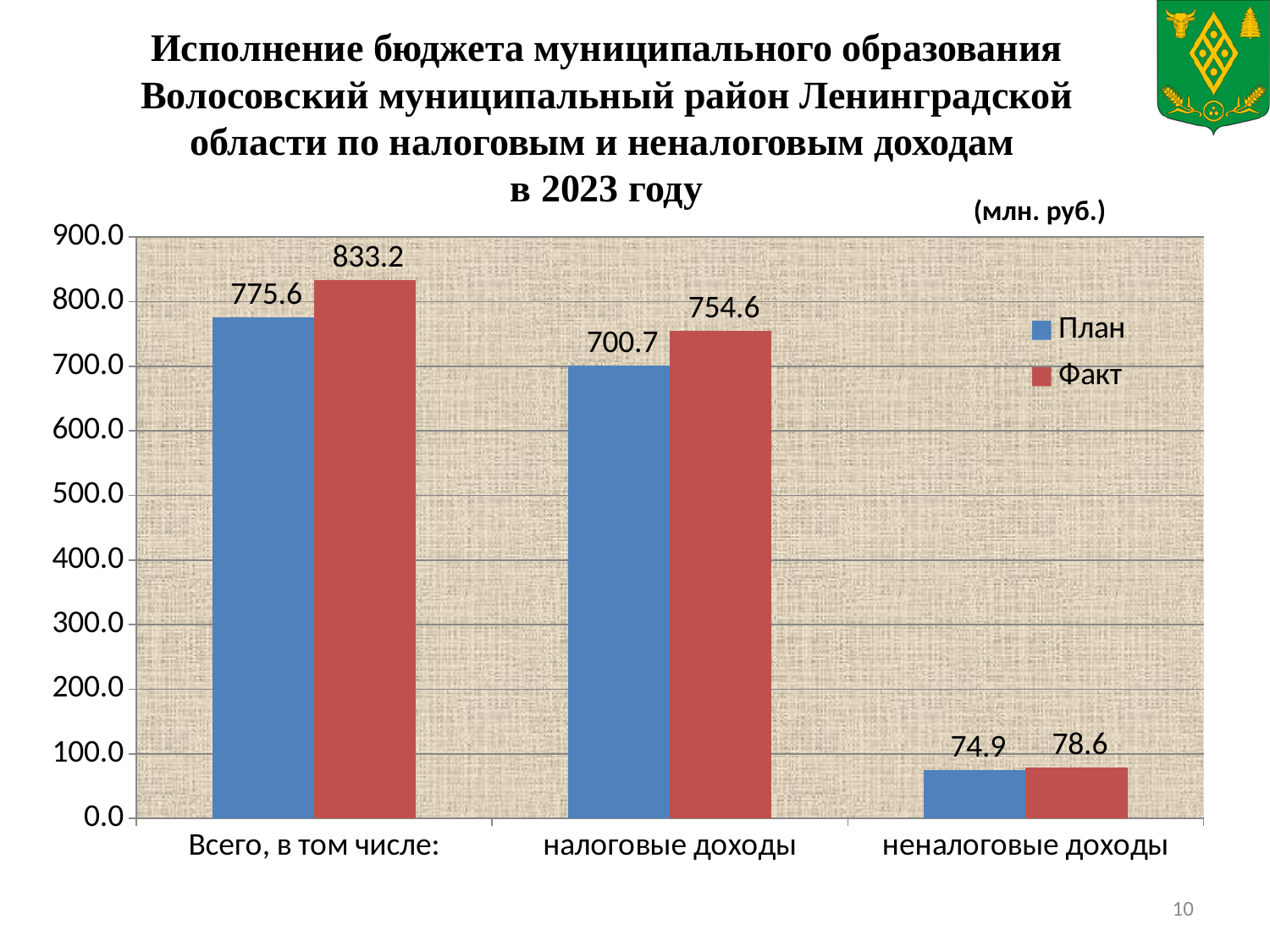
How many series does the legend list? 2 What is the Факт value for Всего, в том числе:? 833.2 Which is larger for неналоговые доходы, План or Факт? Факт What kind of chart is shown on the slide? bar chart What is the difference between the Факт and План values for Всего, в том числе:? 57.6 How many categories are shown on the x axis? 3 What is the Факт value for неналоговые доходы? 78.6 Which category has the lowest Факт value? неналоговые доходы What is the difference between the Факт and План values for налоговые доходы? 53.9 Is the План value for налоговые доходы greater or less than 600.0? greater Which category has the highest План value? Всего, в том числе: What is the План value for налоговые доходы? 700.7